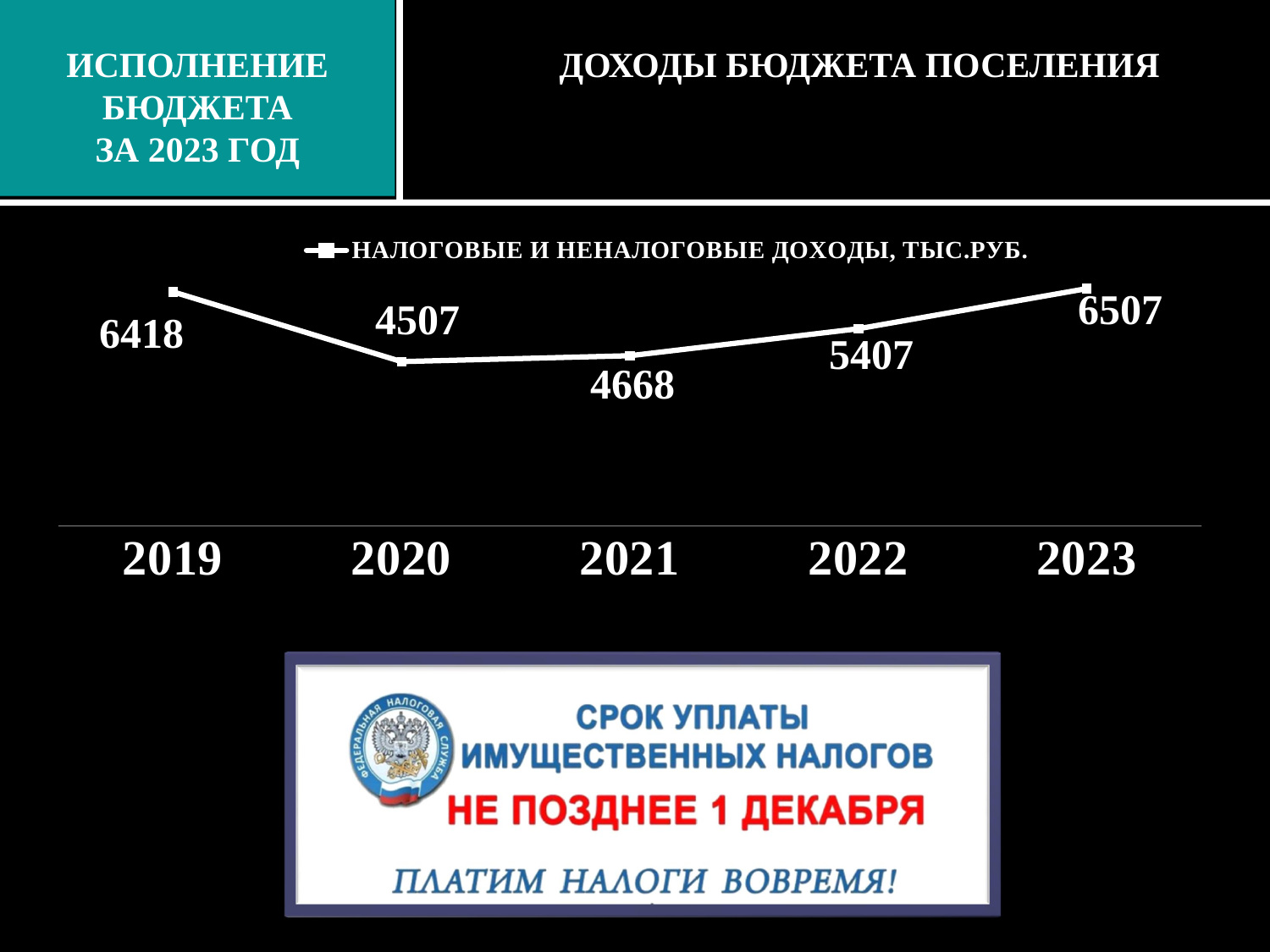
What is the value for 2023? 6507 Which is larger, the value for 2019 or the value for 2022? 2019 What is the value for 2021? 4668 Which year has the highest value? 2023 What is the difference between the values for 2023 and 2019? 89 What kind of chart is shown? line chart What is the value for 2019? 6418 Do the values rise or fall from 2020 to 2023? rise How many series does the legend list? 1 Which year has the lowest value? 2020 How many years are plotted on the chart? 5 What is the difference between the values for 2022 and 2020? 900